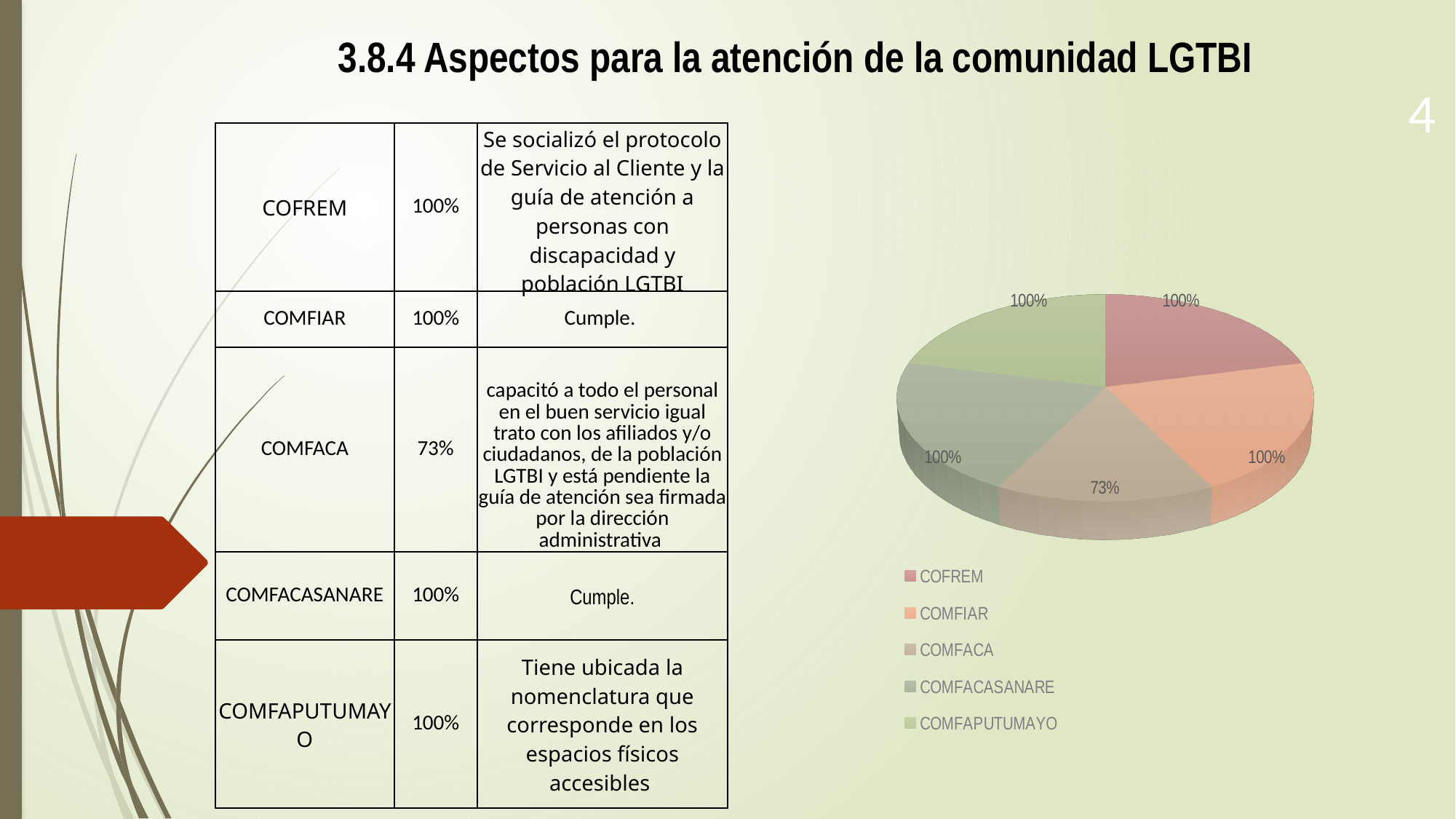
How many slices does the pie chart have? 5 How many entries does the legend of the pie chart list? 5 What value is labelled on the COMFAPUTUMAYO slice of the pie chart? 100% What kind of chart is shown on the slide? Pie chart What value is labelled on the COMFACA slice of the pie chart? 73% What value is labelled on the COFREM slice of the pie chart? 100% What is the difference between the value for COMFACASANARE and the value for COMFACA in the pie chart? 27% Which category has the lowest value in the pie chart? COMFACA Which legend entry is listed last in the pie chart's legend? COMFAPUTUMAYO Which legend entry is listed first in the pie chart's legend? COFREM Which is larger in the pie chart, the value for COMFIAR or the value for COMFACA? COMFIAR